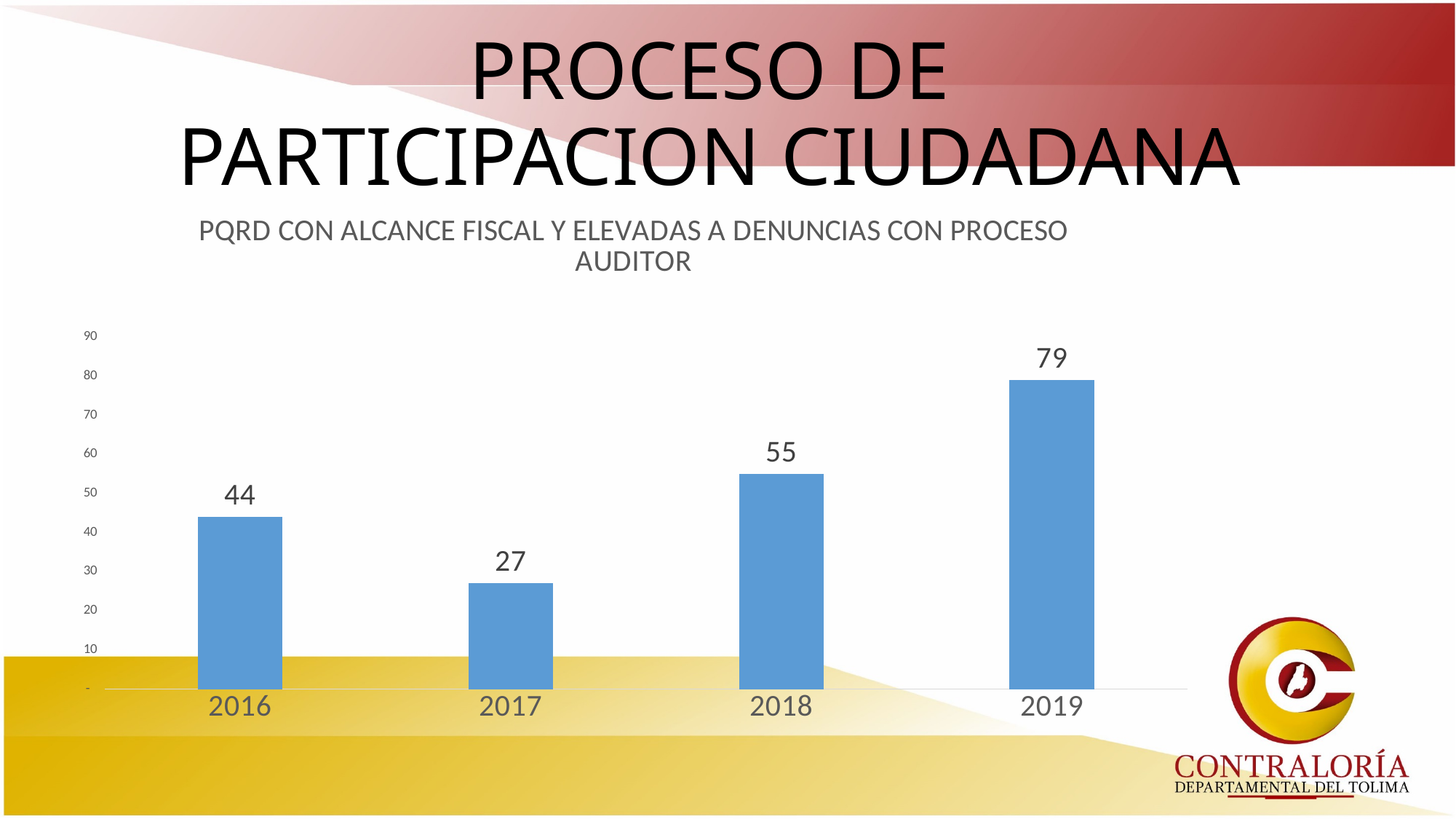
What is the value for 2019? 79 What is the value for 2016? 44 How many years are shown on the chart? 4 Which year has the lowest value? 2017 What is the value for 2017? 27 What is the title of the chart? PQRD CON ALCANCE FISCAL Y ELEVADAS A DENUNCIAS CON PROCESO AUDITOR Which year has the highest value? 2019 What is the difference between the values for 2019 and 2018? 24 What is the difference between the values for 2016 and 2017? 17 What is the value for 2018? 55 What kind of chart is shown on the slide? Bar chart Which is larger, the value for 2016 or the value for 2018? 2018